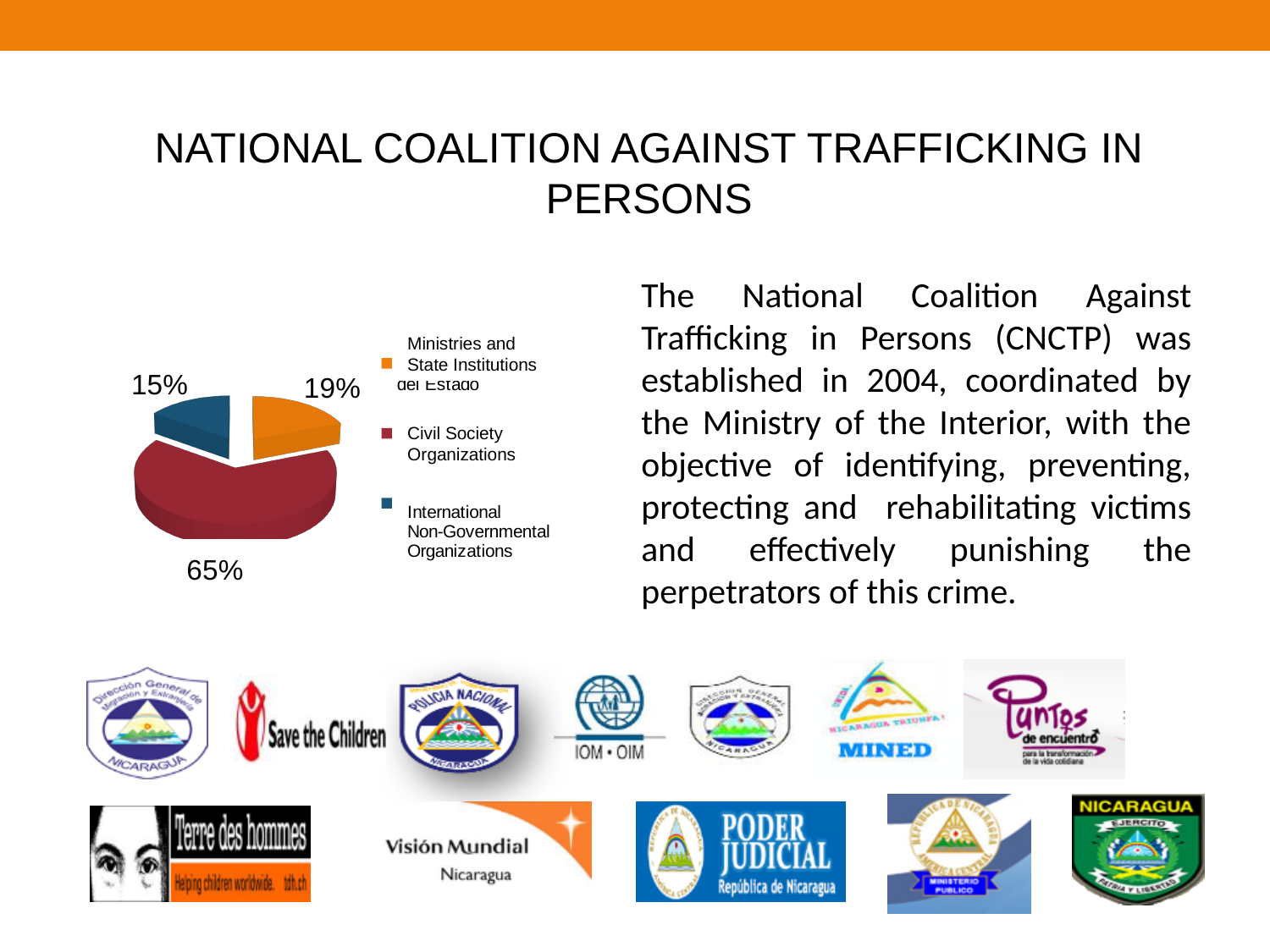
What share of the pie chart is Ministries and State Institutions? 19% What kind of chart is shown on the slide? pie chart What is the difference in percentage points between Ministries and State Institutions and International Non-Governmental Organizations? 4 How many entries does the pie chart legend list? 3 Which category has the smallest slice of the pie chart? International Non-Governmental Organizations How many slices does the pie chart have? 3 Which category has the largest slice of the pie chart? Civil Society Organizations Which is larger in the pie chart: Ministries and State Institutions or International Non-Governmental Organizations? Ministries and State Institutions What colour is the Civil Society Organizations slice in the pie chart? dark red What share of the pie chart is International Non-Governmental Organizations? 15% What is the difference in percentage points between Civil Society Organizations and Ministries and State Institutions? 46 What share of the pie chart is Civil Society Organizations? 65%